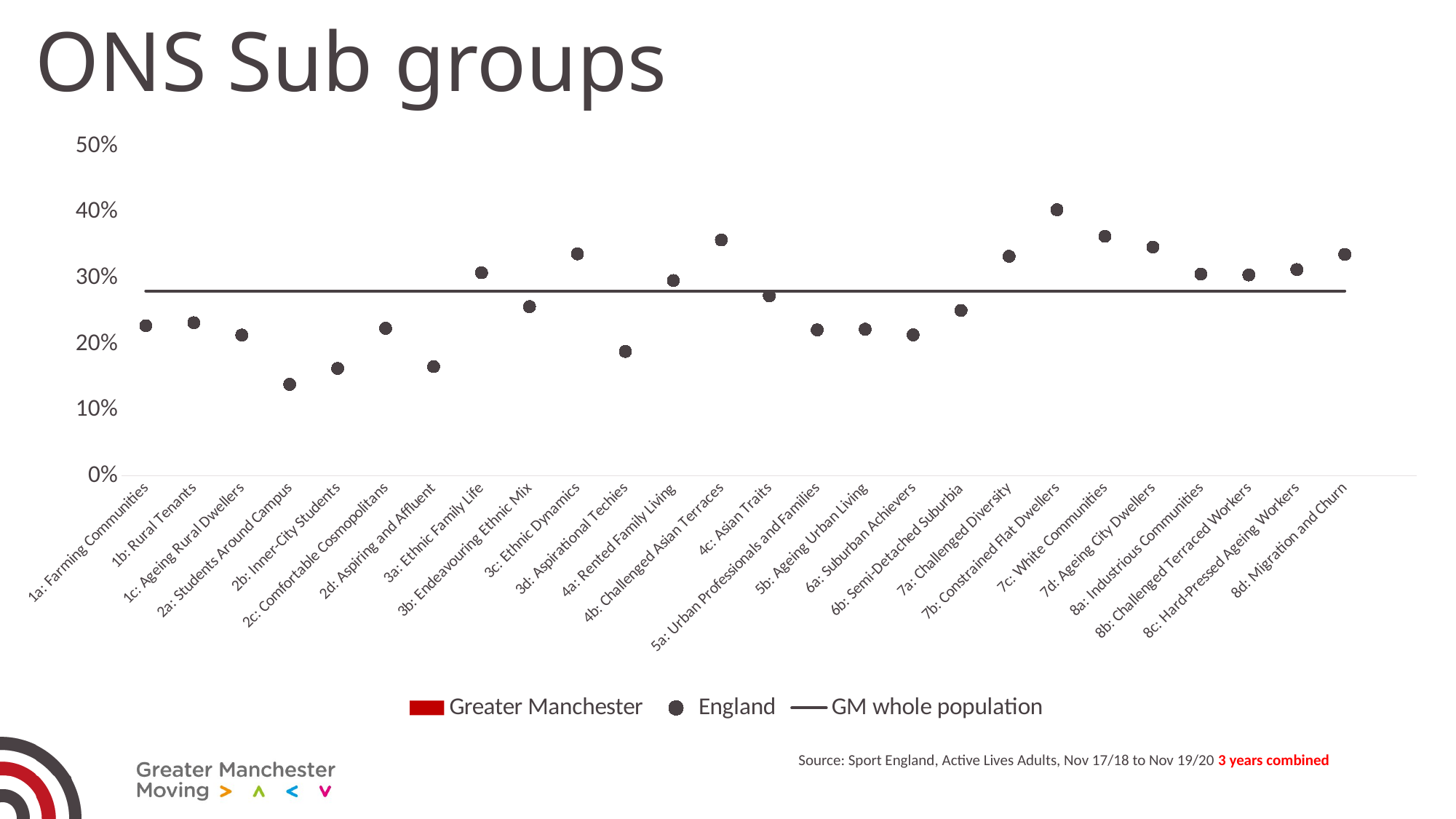
Which sub group has the lowest England value? 2a: Students Around Campus Which sub group has the highest England value? 7b: Constrained Flat Dwellers Which has the larger England value, 7c: White Communities or 6a: Suburban Achievers? 7c: White Communities How many series does the legend list? 3 What does the horizontal line across the chart represent, according to the legend? GM whole population Is the England value for 2a: Students Around Campus greater or less than 20%? less Is the England value for 1a: Farming Communities greater or less than 20%? greater Is the England value for 2b: Inner-City Students greater or less than 20%? less How many ONS sub group categories are shown on the x axis? 26 Which has the larger England value, 3c: Ethnic Dynamics or 3b: Endeavouring Ethnic Mix? 3c: Ethnic Dynamics